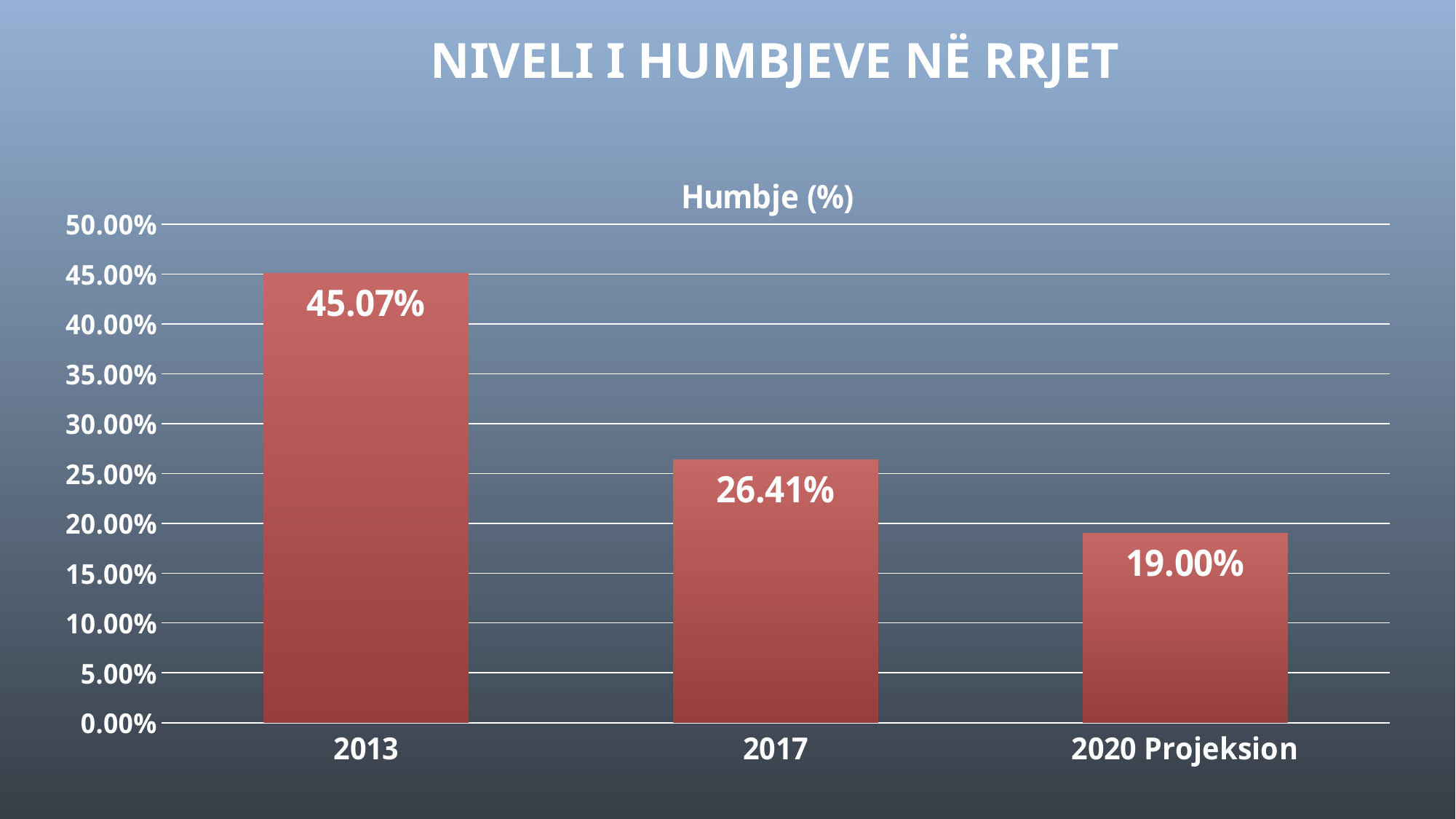
Do the values rise or fall from 2013 to 2020 Projeksion? fall How many categories are shown on the x axis? 3 What is the difference between the values for 2013 and 2017? 18.66% Which is larger, the value for 2017 or the value for 2020 Projeksion? 2017 What kind of chart is shown on the slide? bar chart What is the value for 2020 Projeksion? 19.00% Which category has the lowest value? 2020 Projeksion What is the value for 2017? 26.41% What is the value for 2013? 45.07% What is the difference between the values for 2017 and 2020 Projeksion? 7.41% Is the value for 2017 greater or less than 25.00%? greater Which category has the highest value? 2013